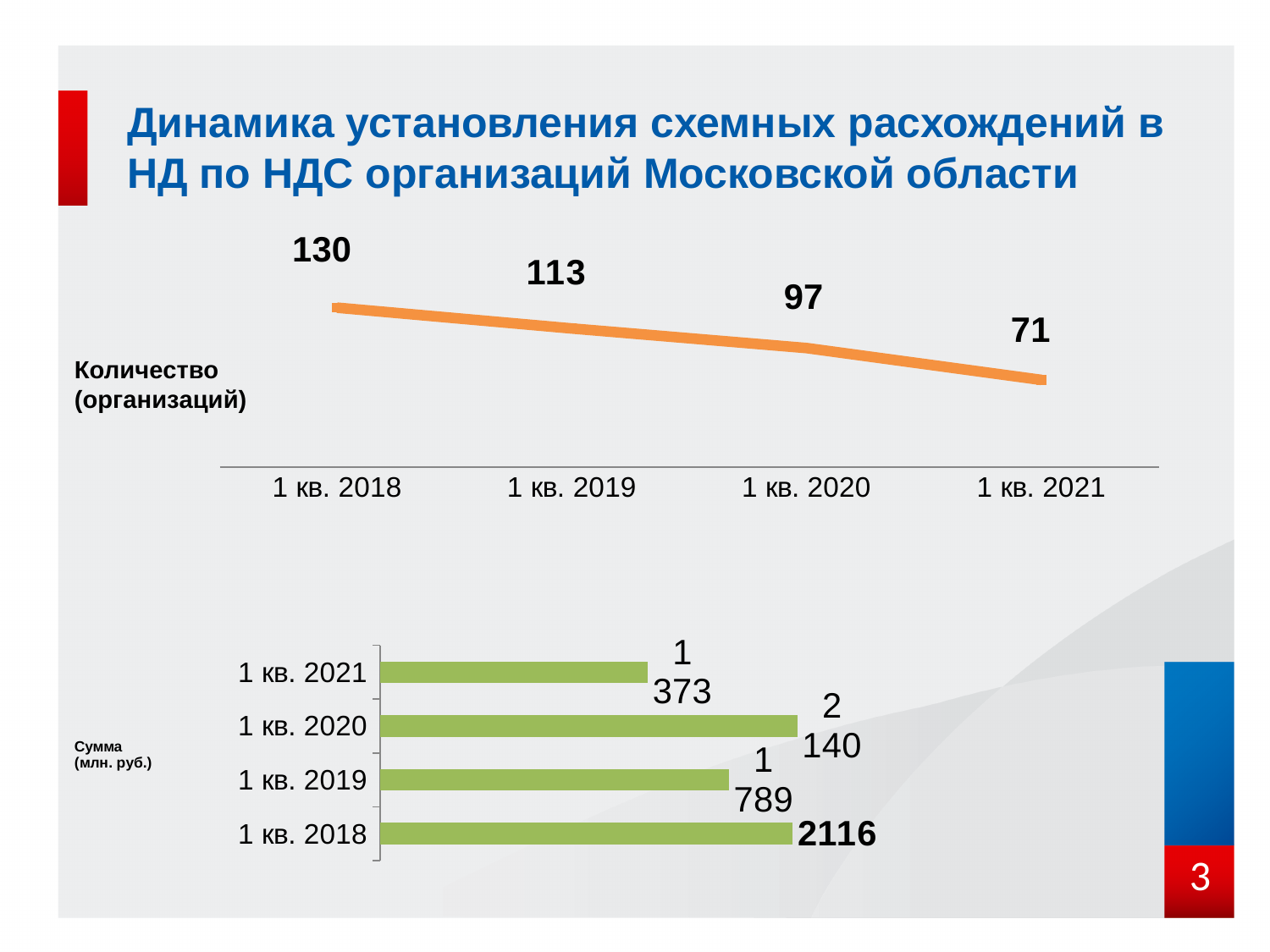
In the top line chart (Количество (организаций)), how many data points are plotted? 4 In the bottom bar chart (Сумма (млн. руб.)), which is larger: the value for 1 кв. 2019 or 1 кв. 2020? 1 кв. 2020 In the bottom bar chart (Сумма (млн. руб.)), what is the value for 1 кв. 2021? 1 373 What kind of chart is the top chart (Количество (организаций))? line chart In the bottom bar chart (Сумма (млн. руб.)), what is the value for 1 кв. 2018? 2116 In the top line chart (Количество (организаций)), do the values rise or fall from 1 кв. 2018 to 1 кв. 2021? fall In the top line chart (Количество (организаций)), what is the value for 1 кв. 2021? 71 In the top line chart (Количество (организаций)), what is the value for 1 кв. 2018? 130 In the top line chart (Количество (организаций)), what is the difference between the values for 1 кв. 2018 and 1 кв. 2021? 59 In the top line chart (Количество (организаций)), which period has the lowest value? 1 кв. 2021 What kind of chart is the bottom chart (Сумма (млн. руб.))? bar chart In the bottom bar chart (Сумма (млн. руб.)), which period has the lowest value? 1 кв. 2021